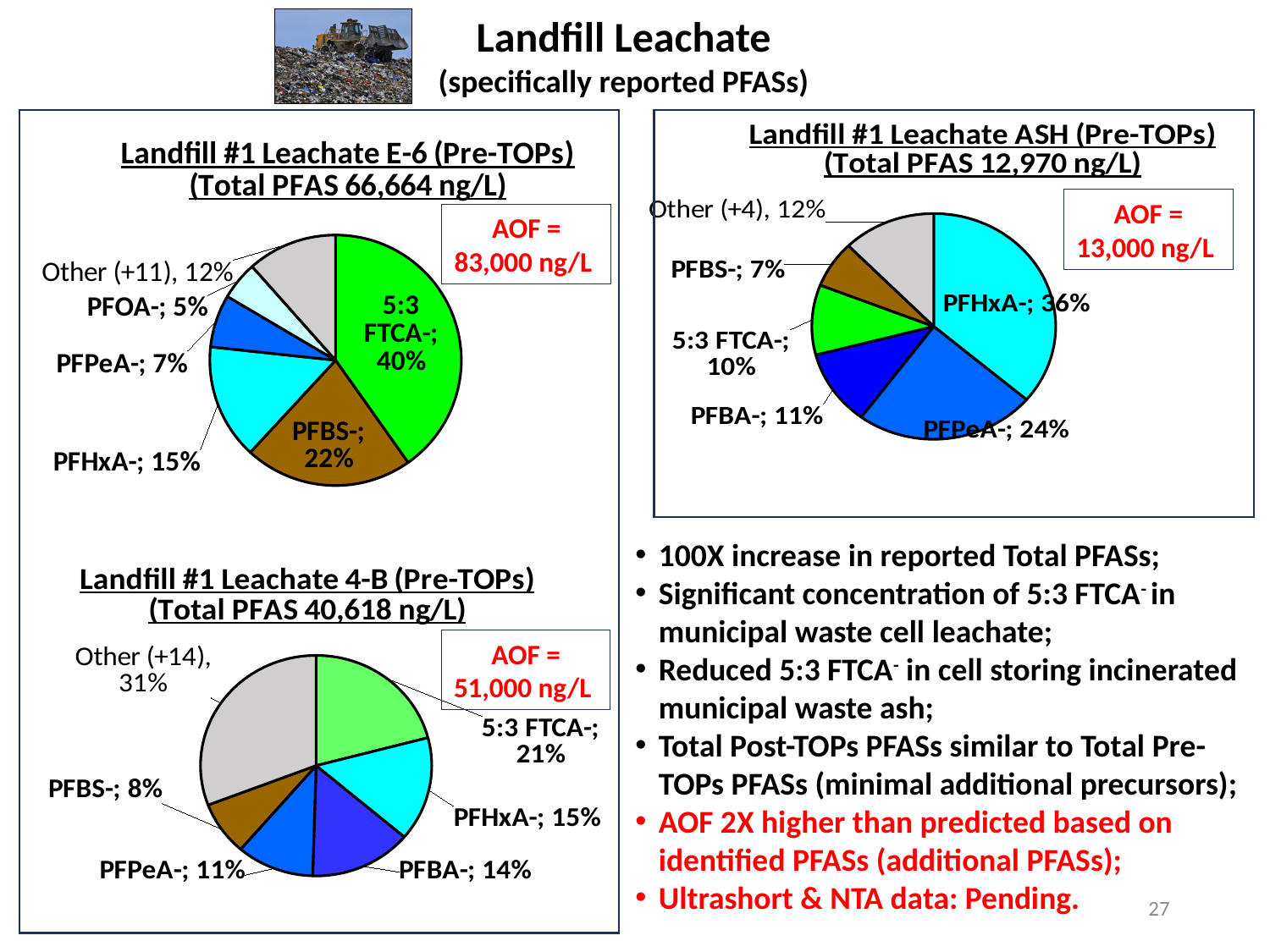
What kind of chart is the Landfill #1 Leachate 4-B (Pre-TOPs) chart? Pie chart In the Landfill #1 Leachate E-6 (Pre-TOPs) chart, which slice is the largest? 5:3 FTCA- In the Landfill #1 Leachate ASH (Pre-TOPs) chart, what share does PFHxA- have? 36% In the Landfill #1 Leachate ASH (Pre-TOPs) chart, which named compound has the smallest share? PFBS- In the Landfill #1 Leachate ASH (Pre-TOPs) chart, which is larger, PFPeA- or PFBA-? PFPeA- In the Landfill #1 Leachate E-6 (Pre-TOPs) chart, what is the difference between the PFBS- share and the PFHxA- share? 7% What AOF value is shown next to the Landfill #1 Leachate E-6 (Pre-TOPs) chart? 83,000 ng/L In the Landfill #1 Leachate 4-B (Pre-TOPs) chart, what share does PFBA- have? 14% In the Landfill #1 Leachate E-6 (Pre-TOPs) chart, what share does 5:3 FTCA- have? 40% In the Landfill #1 Leachate 4-B (Pre-TOPs) chart, what is the difference between the 5:3 FTCA- share and the PFBS- share? 13% In the Landfill #1 Leachate 4-B (Pre-TOPs) chart, which slice is the largest? Other (+14) How many slices does the Landfill #1 Leachate ASH (Pre-TOPs) pie chart have? 6